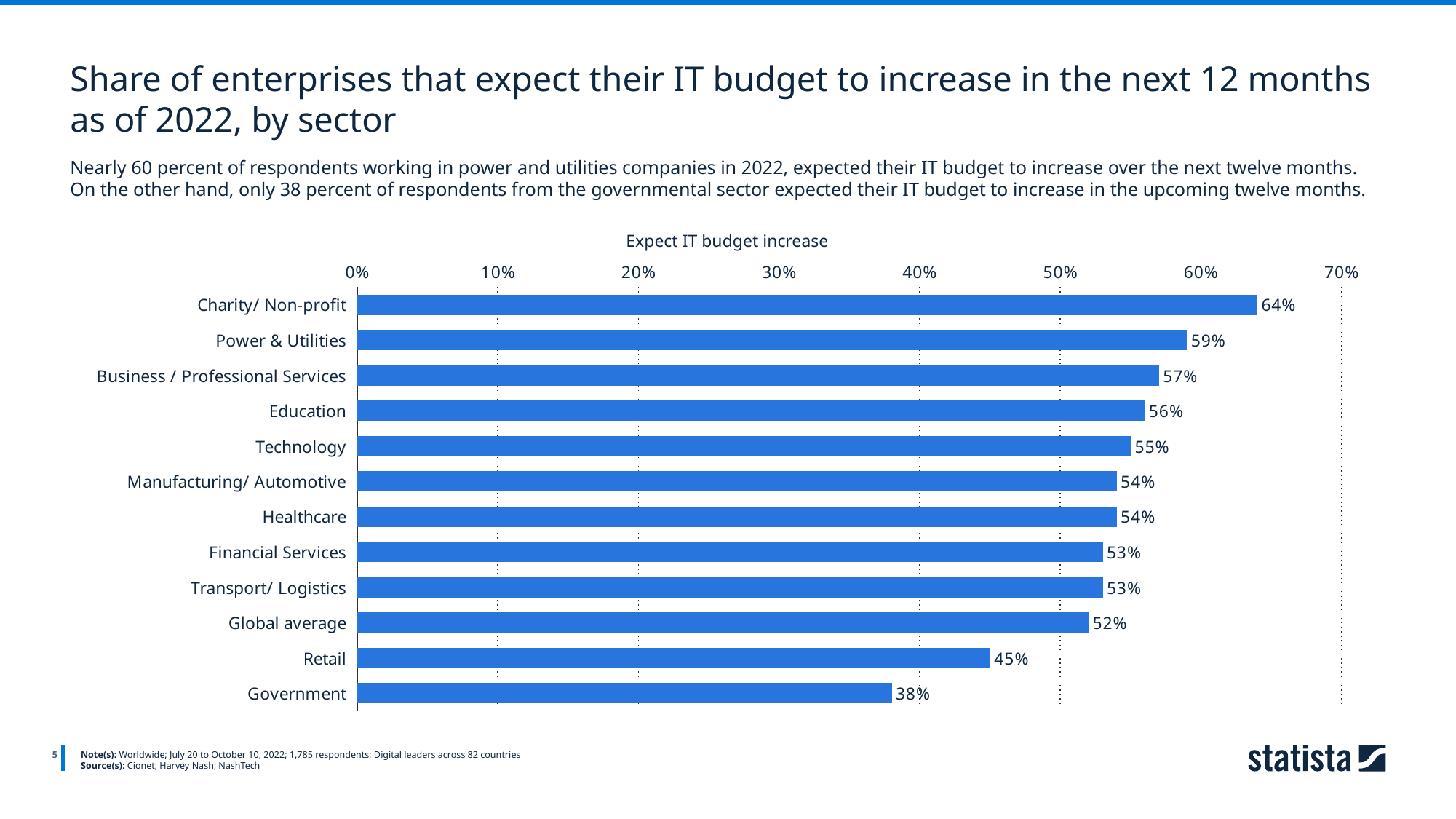
What is the value shown for the Global average? 52% Which sector has the highest share of enterprises expecting an IT budget increase? Charity/ Non-profit What is the difference between the Charity/ Non-profit value and the Global average? 12% What is the difference between the values for Power & Utilities and Retail? 14% What is the title shown above the chart's axis? Expect IT budget increase How many sectors (categories) are shown in the chart? 12 What kind of chart is shown on the slide? Bar chart Which sector has the lowest share of enterprises expecting an IT budget increase? Government Is the value for Retail greater or less than 50%? less Which is larger, the value for Education or the value for Technology? Education What is the value shown for Government? 38% What share of Charity/ Non-profit enterprises expect their IT budget to increase? 64%